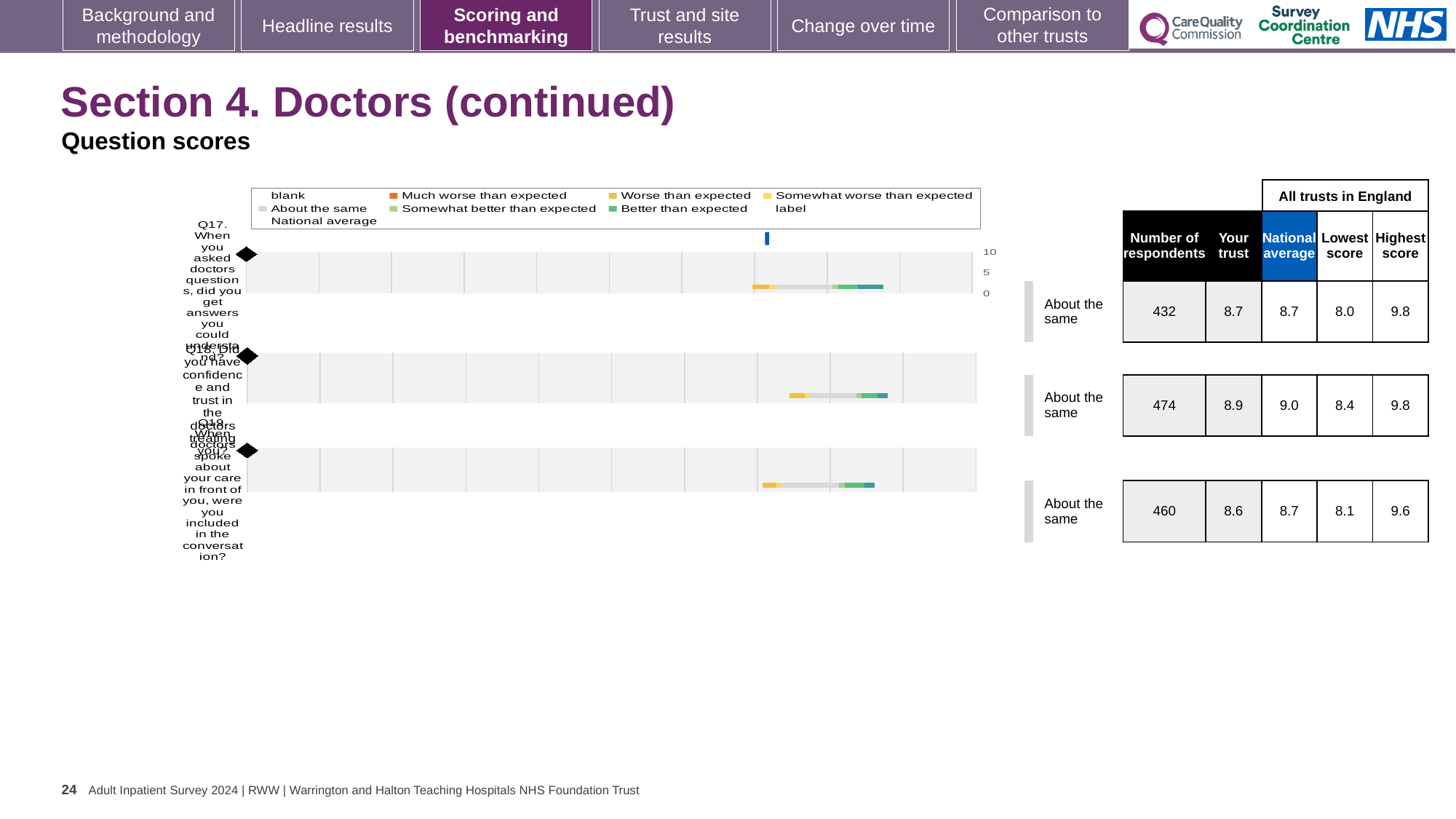
For the Q17 chart (answers you could understand), what is the 'Your trust' score shown in the table? 8.7 For the Q18 chart, how many respondents are listed? 474 Across the three question charts, which question has the lowest 'Your trust' score? Q19 How many question charts (Q17, Q18, Q19) are shown on the slide? 3 What benchmark category is shown next to the Q17 chart? About the same For the Q19 chart (included in the conversation), what is the highest score among all trusts in England? 9.6 Across the three question charts, which question has the highest 'Your trust' score? Q18 What is the highest value shown on the axis of the Q17 chart? 10 For the Q18 chart (confidence and trust in doctors), what is the national average score? 9.0 For the Q18 chart, which is larger: the 'Your trust' score or the national average? National average For the Q17 chart, what is the difference between the highest score and the lowest score among all trusts in England? 1.8 What kind of chart is used to show the question scores for Q17, Q18 and Q19? bar chart